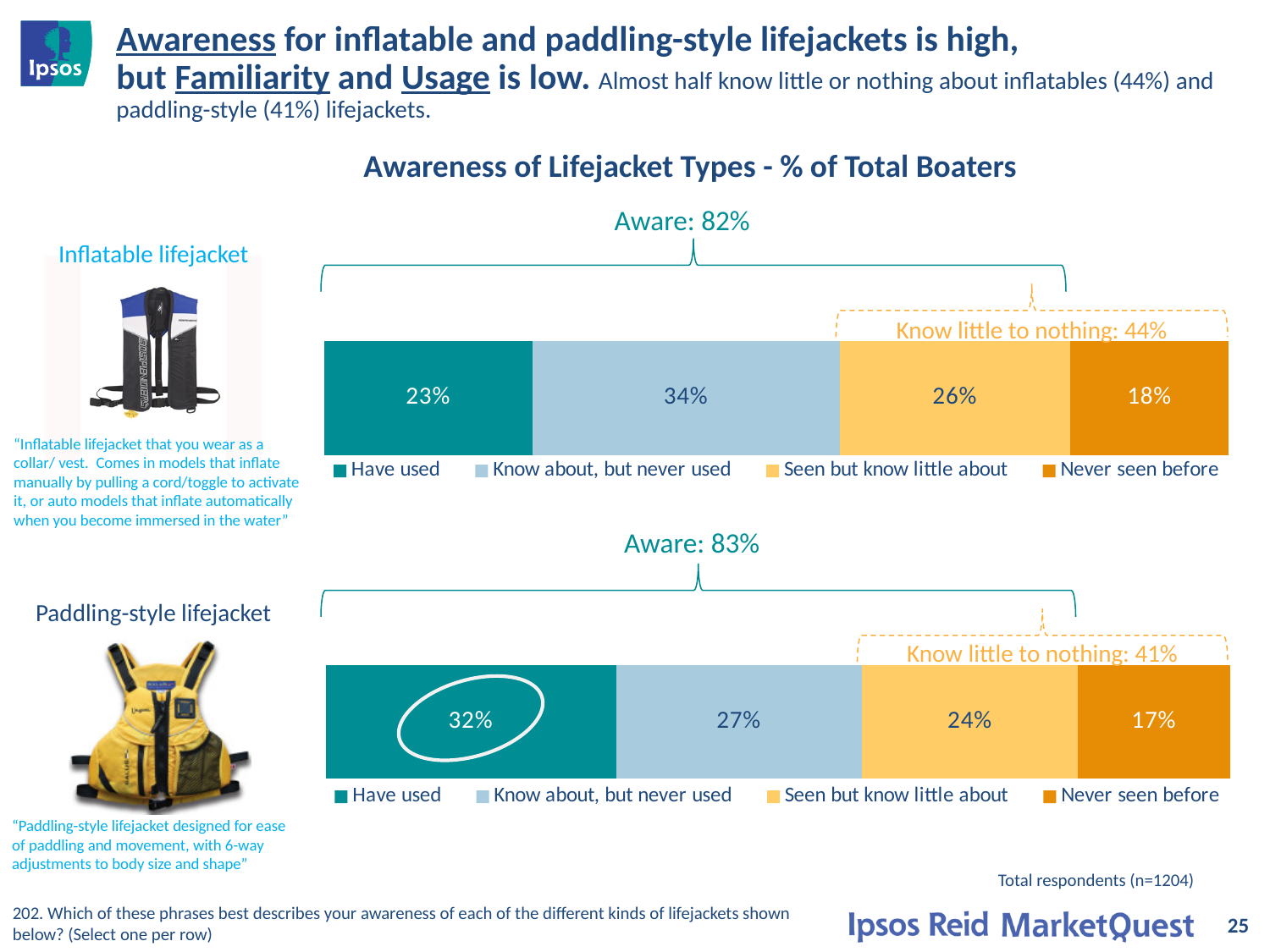
Which is larger: 'Have used' for the Inflatable lifejacket or 'Have used' for the Paddling-style lifejacket? Paddling-style lifejacket What kind of chart is used to show awareness of the Paddling-style lifejacket? Stacked bar chart In the Paddling-style lifejacket chart, what colour is the 'Have used' segment? Teal In the Inflatable lifejacket chart, what percentage of boaters have used an inflatable lifejacket? 23% In the Inflatable lifejacket chart, which category has the highest value? Know about, but never used In the Inflatable lifejacket chart, what is the total of 'Have used' and 'Know about, but never used'? 57% In the Inflatable lifejacket chart, what is the difference between 'Know about, but never used' and 'Have used'? 11% How many series does the legend list in the Inflatable lifejacket chart? 4 In the Paddling-style lifejacket chart, what is the total of 'Seen but know little about' and 'Never seen before'? 41% What is the title of the chart section on the slide? Awareness of Lifejacket Types - % of Total Boaters In the Paddling-style lifejacket chart, which category has the lowest value? Never seen before In the Paddling-style lifejacket chart, what percentage of boaters have never seen a paddling-style lifejacket before? 17%